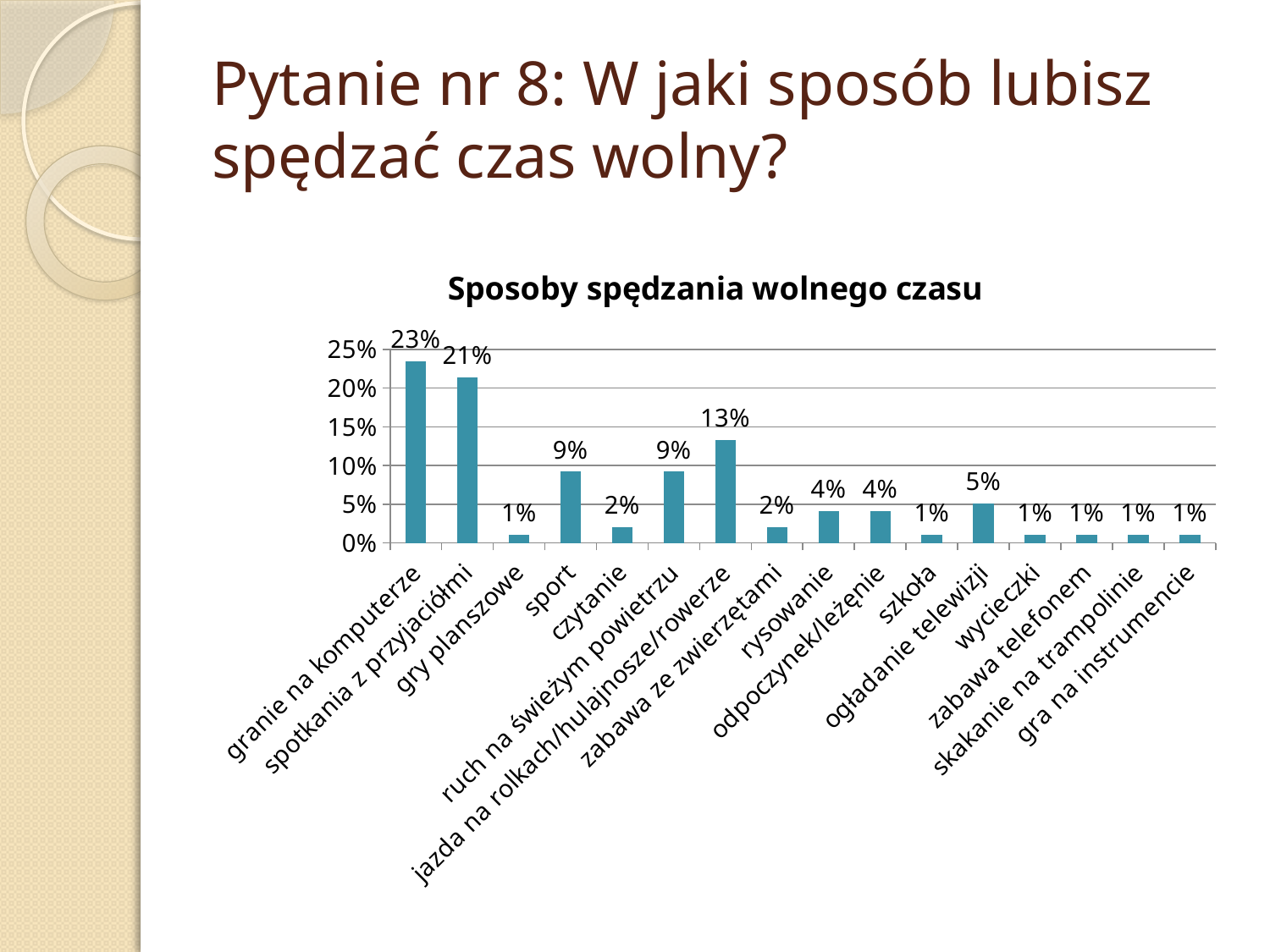
What is the value for 'granie na komputerze'? 23% What is the difference between the values for 'granie na komputerze' and 'spotkania z przyjaciółmi'? 2% How many categories are shown on the x axis? 16 Which category has the highest value? granie na komputerze What is the value for 'rysowanie'? 4% What is the title of the chart? Sposoby spędzania wolnego czasu What is the value for 'oglądanie telewizji'? 5% What is the value for 'jazda na rolkach/hulajnosze/rowerze'? 13% What kind of chart is shown on the slide? bar chart What is the difference between the values for 'jazda na rolkach/hulajnosze/rowerze' and 'sport'? 4% Which is larger, the value for 'oglądanie telewizji' or the value for 'szkoła'? oglądanie telewizji Which is larger, the value for 'sport' or the value for 'czytanie'? sport